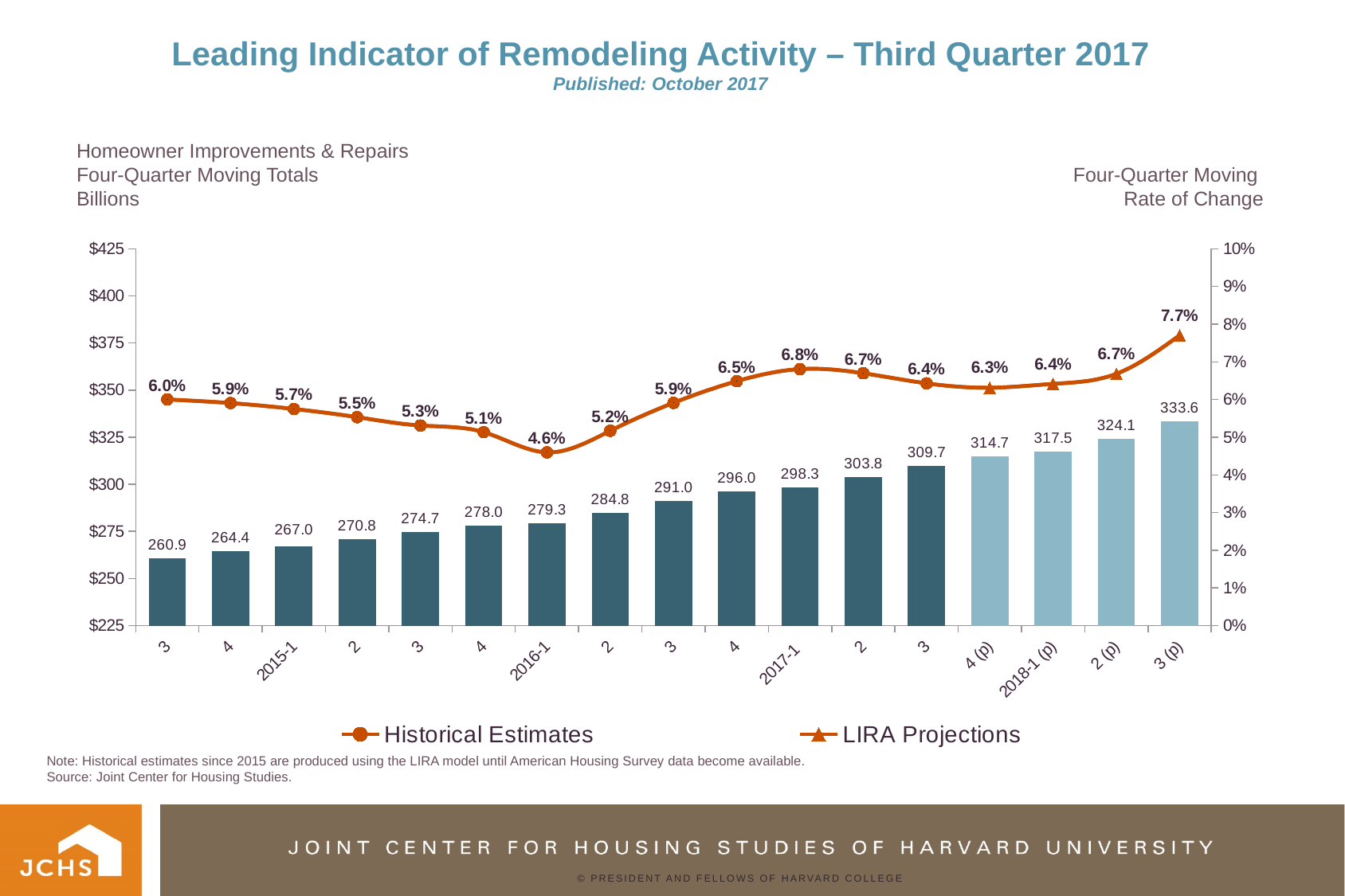
What is the four-quarter moving rate of change for 2016-1? 4.6% Do the four-quarter moving totals rise or fall from left to right across the chart? rise Which is larger, the rate of change for 2017-1 or for 2017 quarter 3? 2017-1 How many series does the legend list? 2 What are the two series named in the legend? Historical Estimates and LIRA Projections How many quarters (bars) are shown on the chart? 17 Is the four-quarter moving total for 2016 quarter 2 greater or less than $300? less Which quarter has the lowest four-quarter moving rate of change? 2016-1 What is the projected four-quarter moving total for 2018 quarter 3 (p)? 333.6 Which quarter has the highest four-quarter moving rate of change? 3 (p) of 2018 What is the difference between the four-quarter moving totals for 2018 quarter 3 (p) and 2017 quarter 3? 23.9 What is the four-quarter moving total (in billions) for 2017-1? 298.3